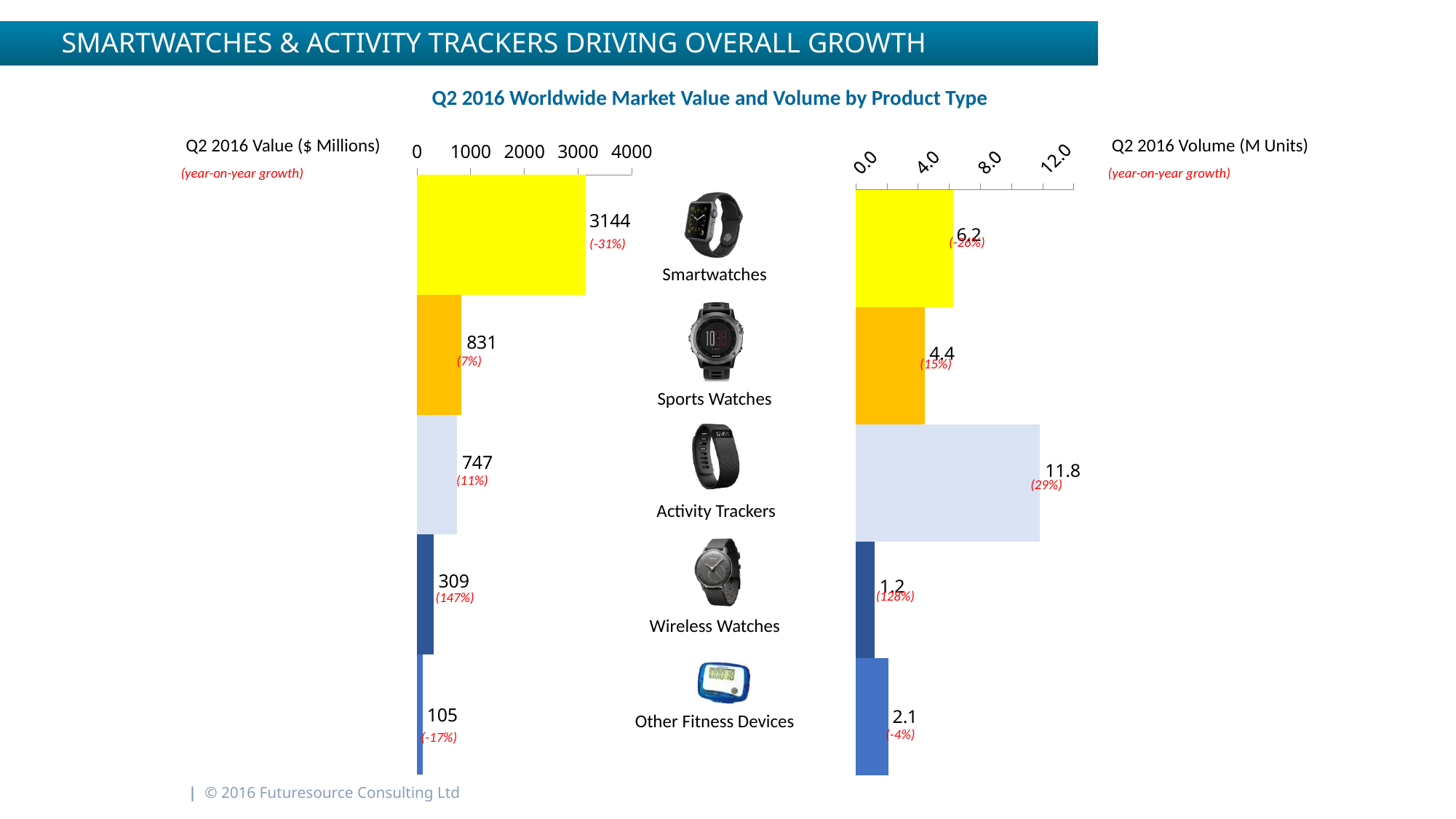
In the Q2 2016 Volume (M Units) chart, what is the difference between the volumes for Smartwatches and Sports Watches? 1.8 In the Q2 2016 Value ($ Millions) chart, what is the value for Smartwatches? 3144 What kind of chart is the Q2 2016 Volume (M Units) chart? Bar chart In the Q2 2016 Value ($ Millions) chart, what is the difference between the values for Sports Watches and Activity Trackers? 84 In the Q2 2016 Value ($ Millions) chart, which is larger, the value for Wireless Watches or Other Fitness Devices? Wireless Watches In the Q2 2016 Volume (M Units) chart, which is larger, the volume for Other Fitness Devices or Wireless Watches? Other Fitness Devices In the Q2 2016 Volume (M Units) chart, what is the volume for Activity Trackers? 11.8 In the Q2 2016 Value ($ Millions) chart, which product type has the lowest value? Other Fitness Devices How many product types are shown in the Q2 2016 Value ($ Millions) chart? 5 In the Q2 2016 Volume (M Units) chart, which product type has the highest volume? Activity Trackers In the Q2 2016 Volume (M Units) chart, which product type has the lowest volume? Wireless Watches In the Q2 2016 Value ($ Millions) chart, what year-on-year growth is shown for Wireless Watches? 147%